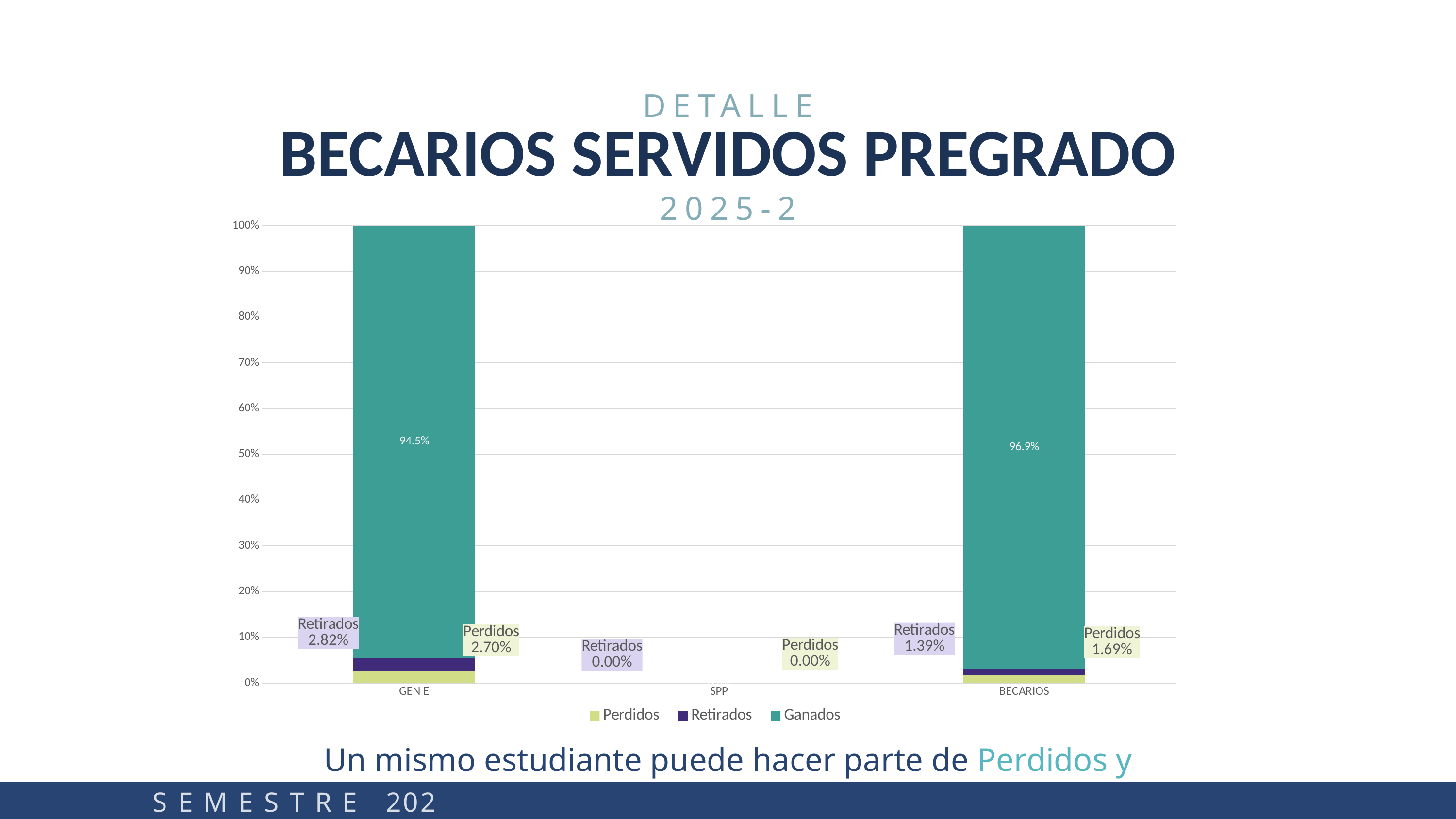
What is the Perdidos value for BECARIOS? 1.69% What is the Ganados value for GEN E? 94.5% How many series does the legend list? 3 What is the difference between the Retirados values for GEN E and BECARIOS? 1.43% Which category has the highest Perdidos value? GEN E What is the Ganados value for BECARIOS? 96.9% What is the Retirados value for GEN E? 2.82% Which category has the higher Ganados value, GEN E or BECARIOS? BECARIOS How many categories are shown on the x axis? 3 Which series is shown in teal in the legend? Ganados What kind of chart is shown on the slide? Stacked bar chart What is the Retirados value for SPP? 0.00%